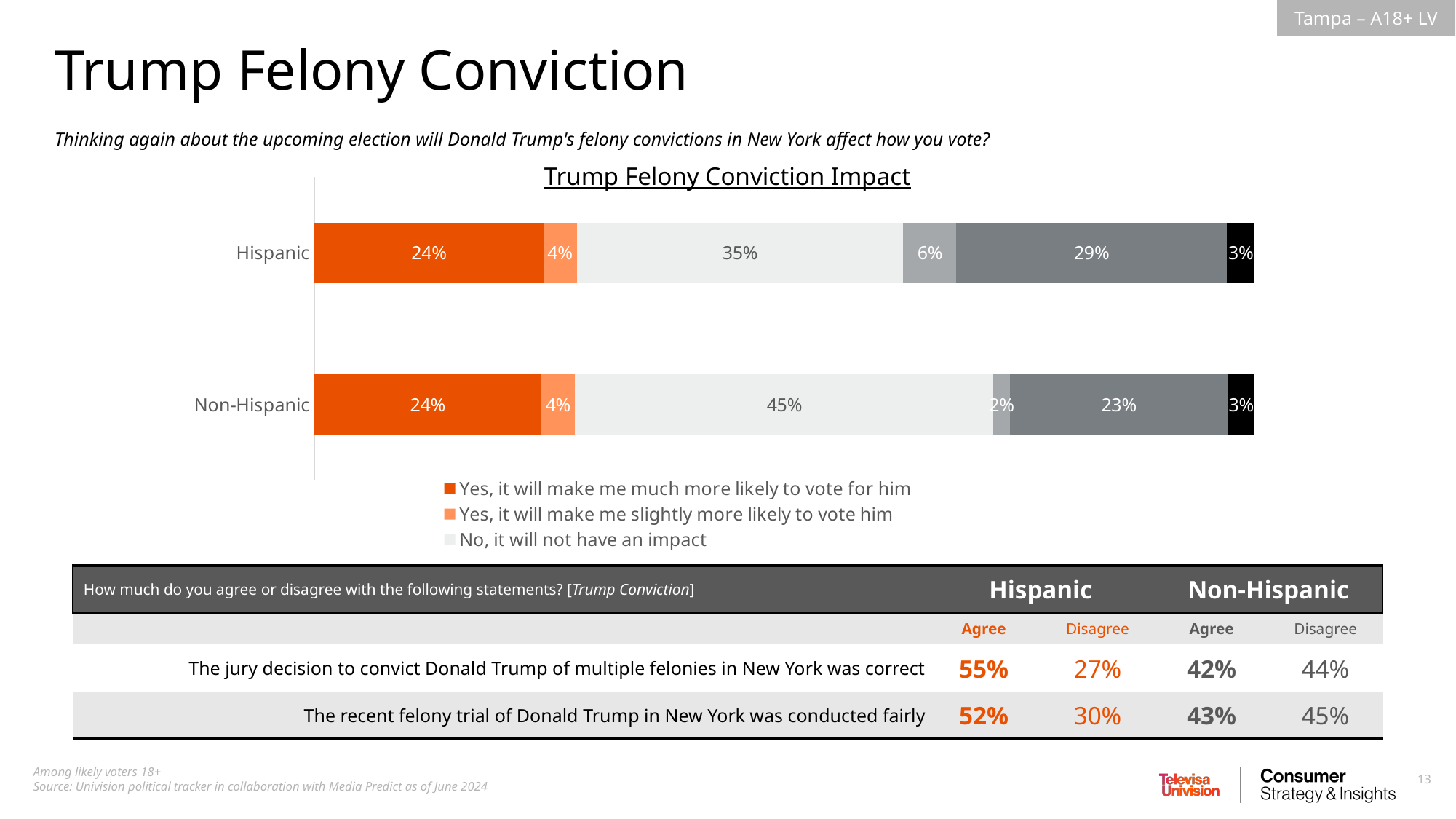
What type of chart is the Trump Felony Conviction Impact chart? Stacked bar chart In the Trump Felony Conviction Impact chart, what percentage of Non-Hispanic respondents said "Yes, it will make me slightly more likely to vote him"? 4% How many respondent groups (bars) are shown in the Trump Felony Conviction Impact chart? 2 In the Trump Felony Conviction Impact chart, which group has the larger share for "No, it will not have an impact", Hispanic or Non-Hispanic? Non-Hispanic In the Trump Felony Conviction Impact chart, what is the value of the dark grey segment (fifth from the left) in the Hispanic bar? 29% What colour represents "Yes, it will make me much more likely to vote for him" in the Trump Felony Conviction Impact chart? Dark orange In the Trump Felony Conviction Impact chart, what percentage of Hispanic respondents said "Yes, it will make me much more likely to vote for him"? 24% In the Trump Felony Conviction Impact chart, what is the value of the dark grey segment (fifth from the left) in the Non-Hispanic bar? 23% In the Trump Felony Conviction Impact chart, what percentage of Non-Hispanic respondents said "No, it will not have an impact"? 45% In the Trump Felony Conviction Impact chart, what percentage of Hispanic respondents said "No, it will not have an impact"? 35% In the Trump Felony Conviction Impact chart, which response segment is the largest within the Hispanic bar? No, it will not have an impact In the Trump Felony Conviction Impact chart, how many percentage points higher is the "No, it will not have an impact" share for Non-Hispanic respondents than for Hispanic respondents? 10 percentage points